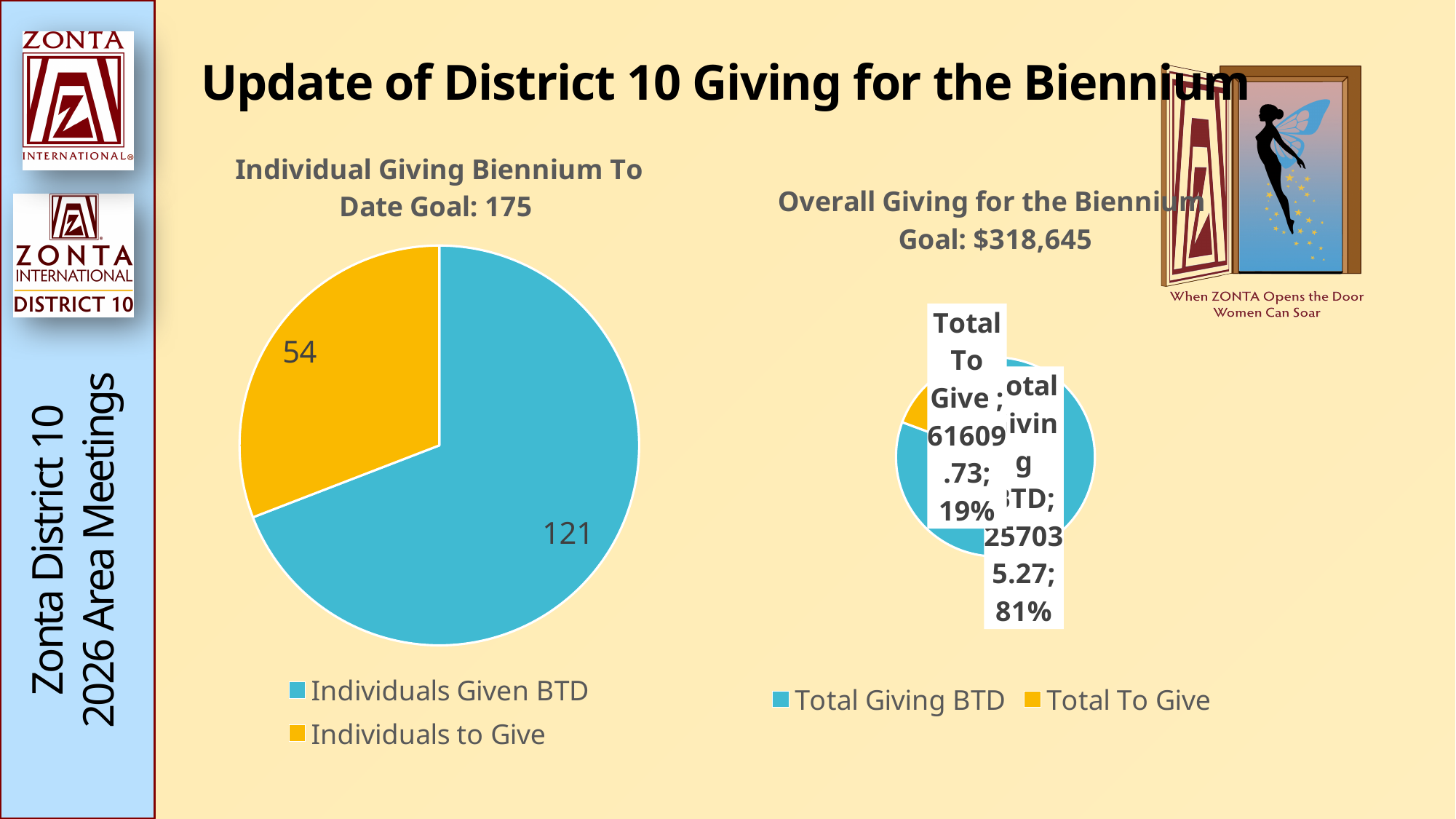
What kind of chart is the Individual Giving Biennium To Date chart? Pie chart What goal amount is stated in the title of the Overall Giving for the Biennium chart? $318,645 In the Overall Giving for the Biennium chart, what percentage share is labelled for Total To Give? 19% How many slices does the Individual Giving Biennium To Date chart have? 2 In the Individual Giving Biennium To Date chart, what is the value for Individuals Given BTD? 121 In the Overall Giving for the Biennium chart, what percentage share is labelled for Total Giving BTD? 81% In the Overall Giving for the Biennium chart, which slice is smaller, Total Giving BTD or Total To Give? Total To Give In the Individual Giving Biennium To Date chart, what is the value for Individuals to Give? 54 In the Individual Giving Biennium To Date chart, what is the difference between Individuals Given BTD and Individuals to Give? 67 In the Individual Giving Biennium To Date chart, which slice is larger, Individuals Given BTD or Individuals to Give? Individuals Given BTD In the Individual Giving Biennium To Date chart, what is the total of the two slices? 175 How many entries does the legend of the Overall Giving for the Biennium chart list? 2